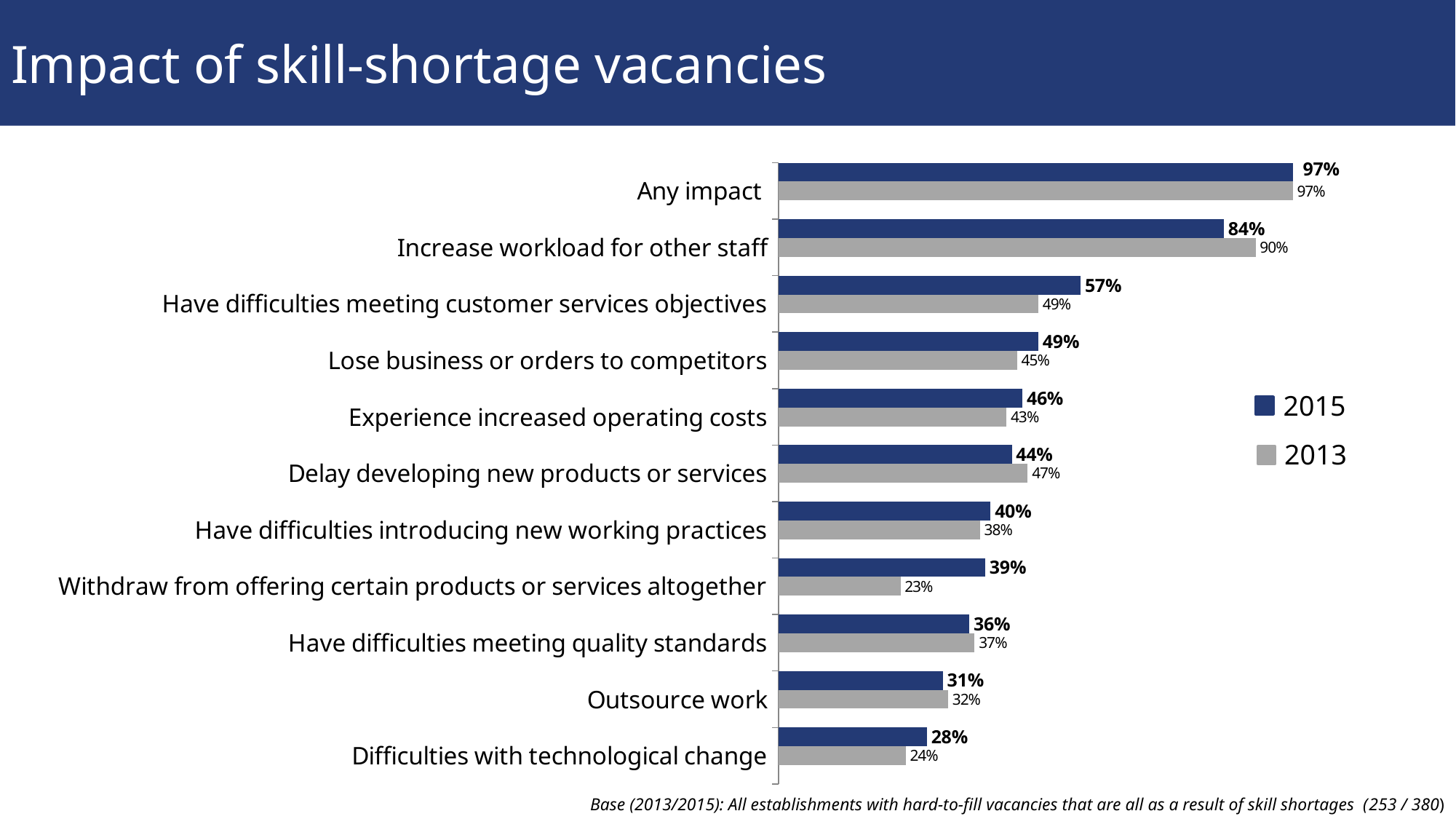
For 'Have difficulties meeting customer services objectives', which year has the larger value, 2015 or 2013? 2015 What is the 2013 value for 'Withdraw from offering certain products or services altogether'? 23% For 'Delay developing new products or services', which year has the larger value, 2015 or 2013? 2013 What is the difference between the 2013 and 2015 values for 'Increase workload for other staff'? 6 percentage points What is the difference between the 2015 and 2013 values for 'Withdraw from offering certain products or services altogether'? 16 percentage points How many categories are shown on the chart? 11 What kind of chart is shown on the slide? Bar chart What is the 2015 value for 'Outsource work'? 31% Which category has the highest 2013 value? Any impact What is the 2015 value for 'Increase workload for other staff'? 84% Which category has the lowest 2015 value? Difficulties with technological change How many series does the legend list? 2